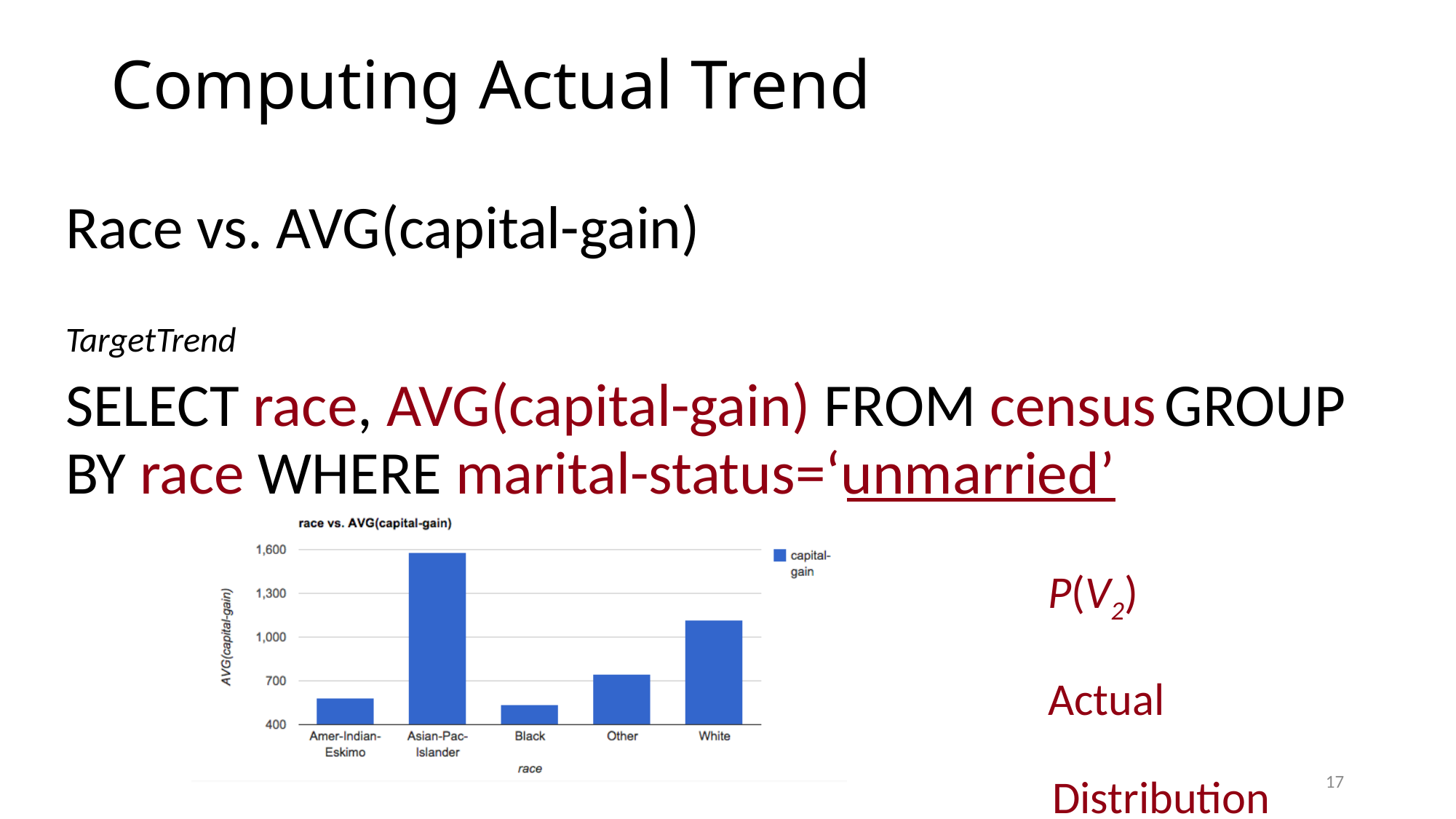
What is the title of the chart? race vs. AVG(capital-gain) Which is larger in the chart, the value for White or the value for Other? White How many race categories are plotted on the x axis of the chart? 5 Is the value for White greater or less than 1,000? greater Which is larger in the chart, the value for Asian-Pac-Islander or the value for White? Asian-Pac-Islander Is the value for Other greater or less than 1,000? less How many series does the chart's legend list? 1 What is the label of the series shown in the chart's legend? capital-gain What kind of chart is shown on the slide? bar chart Is the value for Black greater or less than 700? less Which race category has the highest AVG(capital-gain) in the chart? Asian-Pac-Islander